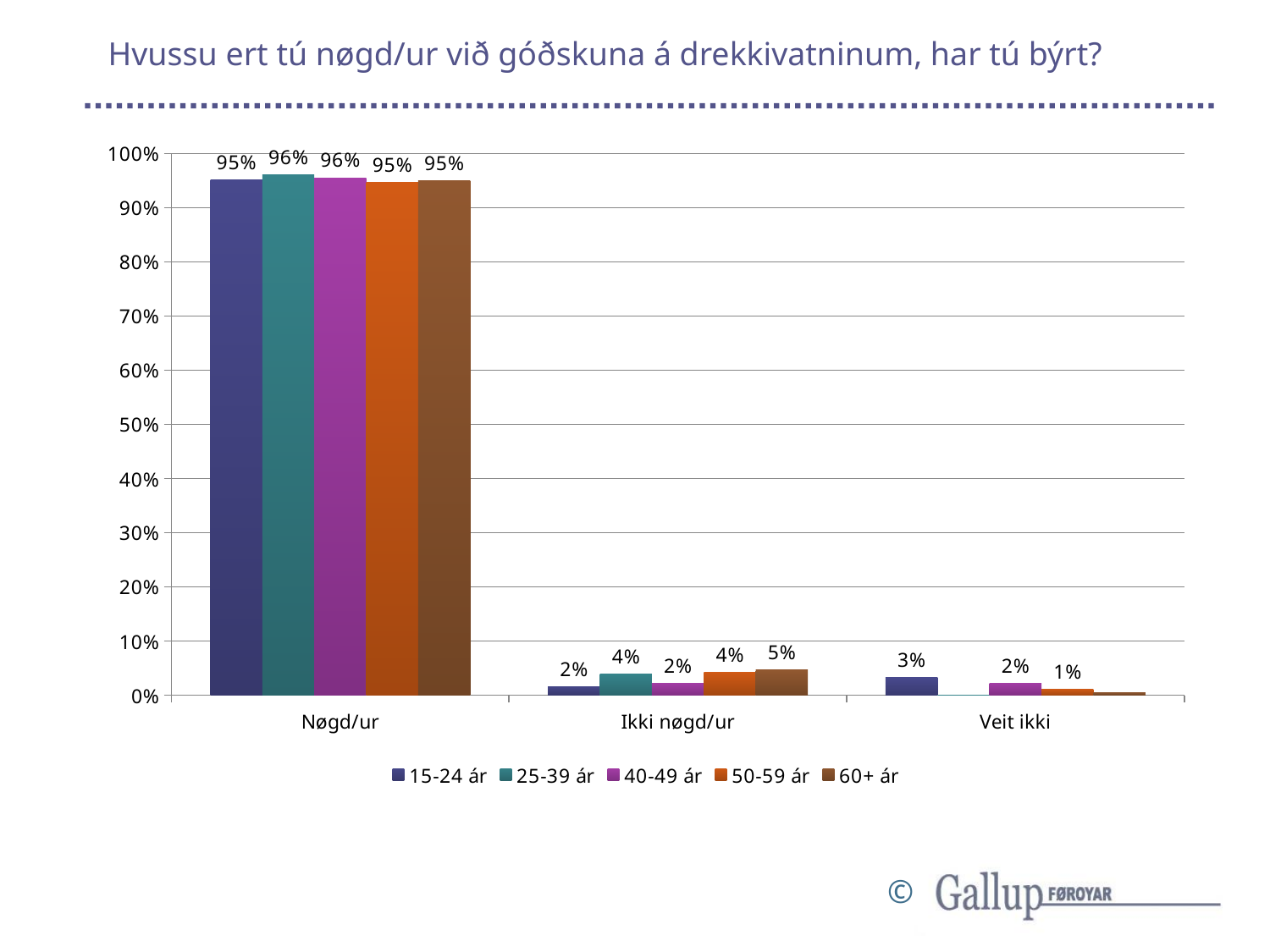
What is the value for the 60+ ár series in the Ikki nøgd/ur category? 5% How many categories are shown on the x axis? 3 In the Ikki nøgd/ur category, which age group has the highest value? 60+ ár In the Nøgd/ur category, which is larger: the 25-39 ár value or the 15-24 ár value? 25-39 ár What is the value for the 15-24 ár series in the Veit ikki category? 3% What is the value for the 15-24 ár series in the Nøgd/ur category? 95% What kind of chart is shown on the slide? bar chart What is the value for the 50-59 ár series in the Veit ikki category? 1% Is the value for the 40-49 ár series in the Nøgd/ur category greater or less than 90%? greater How many series does the legend list? 5 What is the title of the slide? Hvussu ert tú nøgd/ur við góðskuna á drekkivatninum, har tú býrt? In the Ikki nøgd/ur category, what is the difference between the 60+ ár value and the 15-24 ár value? 3 percentage points